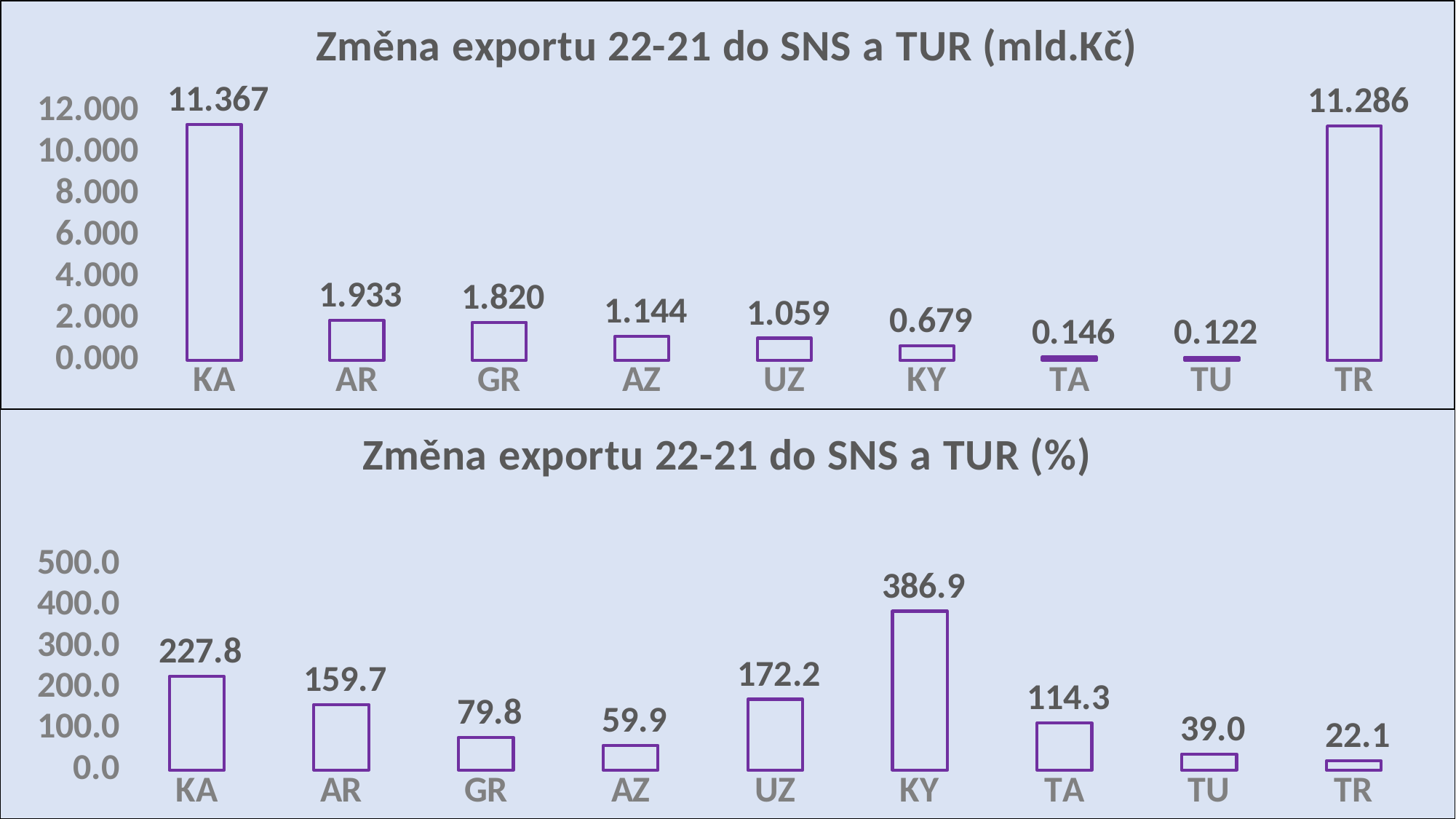
In the chart titled "Změna exportu 22-21 do SNS a TUR (mld.Kč)", what is the value for KA? 11.367 In the chart titled "Změna exportu 22-21 do SNS a TUR (%)", which category has the highest value? KY In the chart titled "Změna exportu 22-21 do SNS a TUR (%)", what is the difference between the values for KA and AR? 68.1 In the chart titled "Změna exportu 22-21 do SNS a TUR (mld.Kč)", what is the value for TU? 0.122 In the chart titled "Změna exportu 22-21 do SNS a TUR (mld.Kč)", which is larger, the value for AR or the value for GR? AR In the chart titled "Změna exportu 22-21 do SNS a TUR (mld.Kč)", how many categories are shown on the x axis? 9 In the chart titled "Změna exportu 22-21 do SNS a TUR (mld.Kč)", which category has the lowest value? TU In the chart titled "Změna exportu 22-21 do SNS a TUR (%)", which category has the lowest value? TR What kind of chart is the bottom chart on the slide? Bar chart In the chart titled "Změna exportu 22-21 do SNS a TUR (%)", what is the value for KY? 386.9 In the chart titled "Změna exportu 22-21 do SNS a TUR (mld.Kč)", what is the difference between the values for KA and TR? 0.081 In the chart titled "Změna exportu 22-21 do SNS a TUR (%)", is the value for UZ greater or less than 100.0? greater